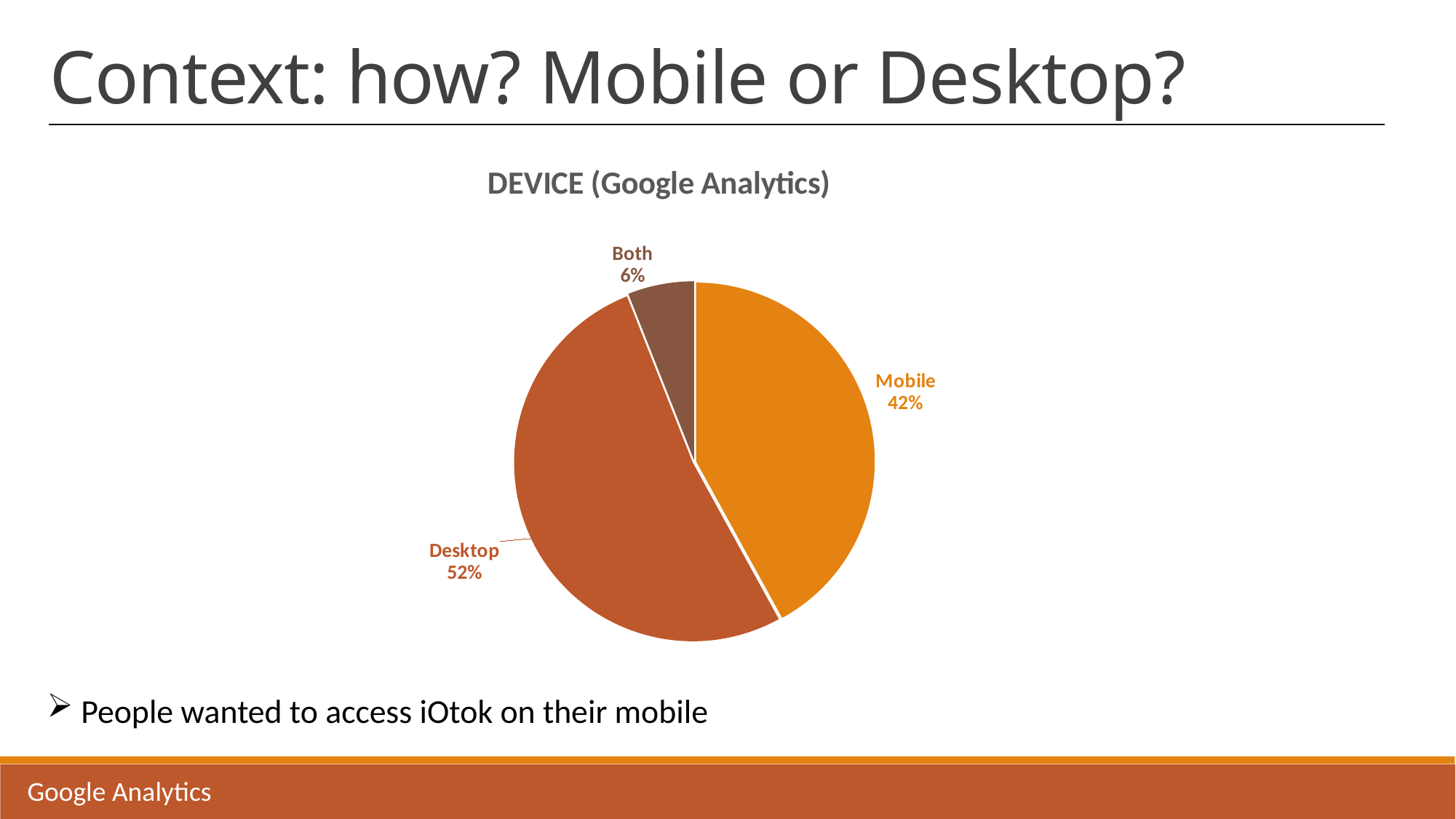
Which category has the largest slice of the pie? Desktop Which slice is coloured dark brown? Both What is the difference in percentage points between Mobile and Both? 36 Which is larger, the Mobile slice or the Both slice? Mobile What type of chart is shown on the slide? pie chart What share of the pie does Desktop represent? 52% What share of the pie does Mobile represent? 42% What is the difference in percentage points between Desktop and Mobile? 10 Which category has the smallest slice of the pie? Both What is the title of the chart? DEVICE (Google Analytics) What share of the pie does Both represent? 6% How many slices does the pie chart have? 3